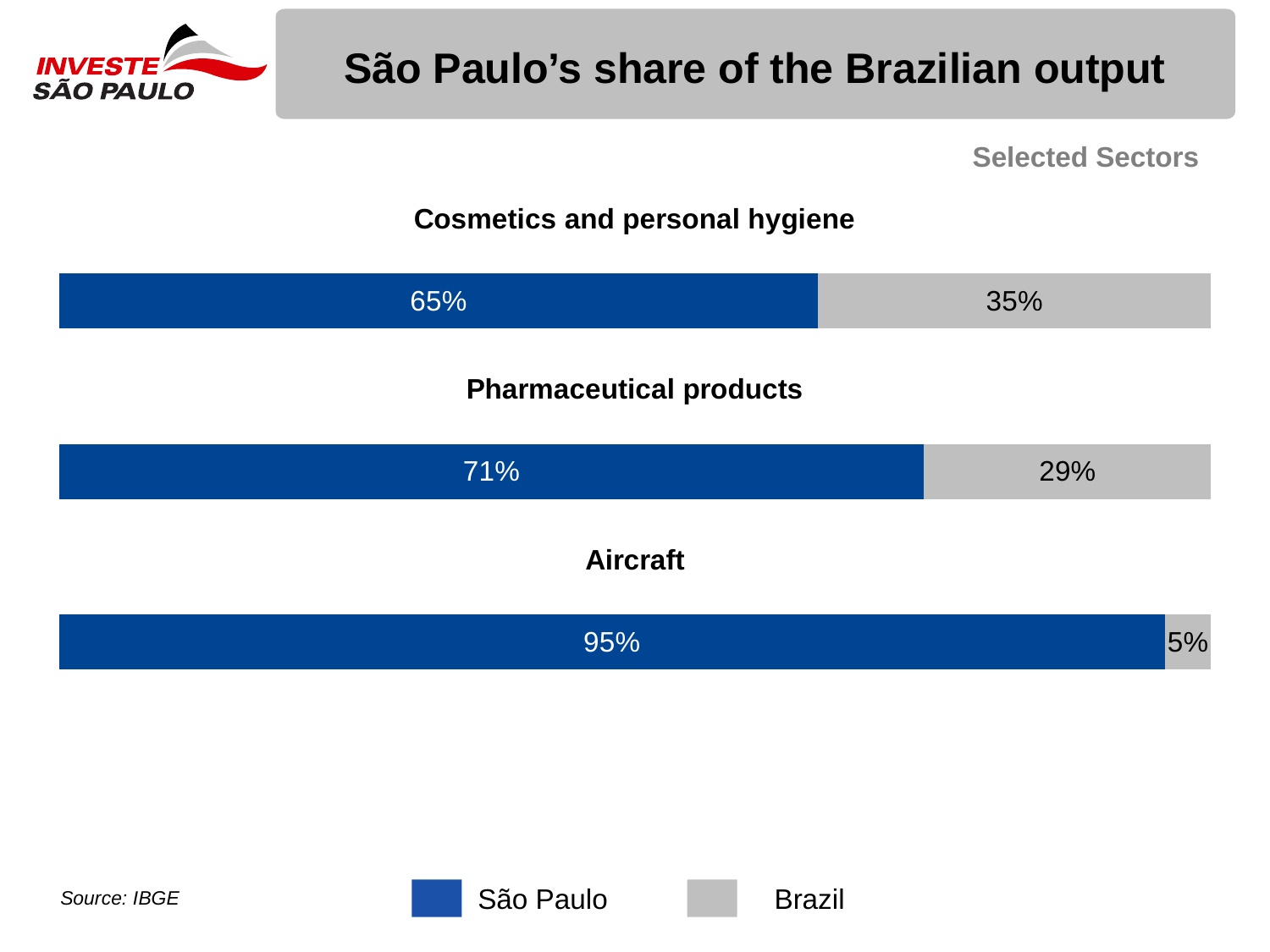
What kind of chart is shown on the slide? Stacked bar chart In which sector does São Paulo have the lowest share of Brazilian output? Cosmetics and personal hygiene Which is larger: São Paulo's share for Pharmaceutical products or for Aircraft? Aircraft What is São Paulo's share of the Brazilian output for Cosmetics and personal hygiene? 65% In which sector does São Paulo have the highest share of Brazilian output? Aircraft What is São Paulo's share for Aircraft? 95% How many series does the legend list? 2 Which colour represents São Paulo in the legend? Blue What is the Brazil share shown for Pharmaceutical products? 29% How many sectors are shown on the chart? 3 What is the Brazil share shown for Aircraft? 5% What is the difference between São Paulo's share for Pharmaceutical products and for Cosmetics and personal hygiene? 6%